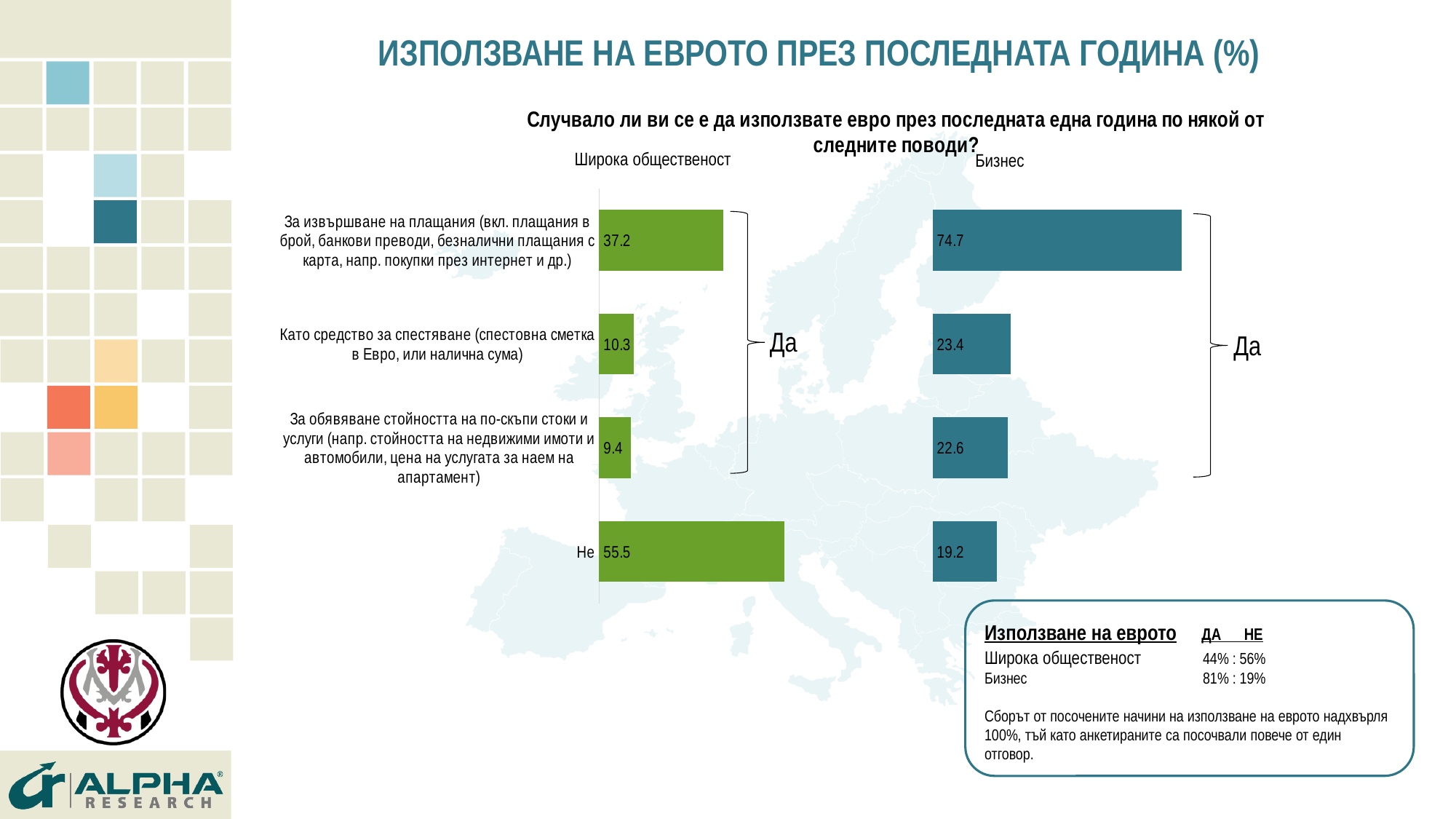
In the "Бизнес" chart, which category has the highest value? За извършване на плащания In the "Широка общественост" chart, which category has the lowest value? За обявяване стойността на по-скъпи стоки и услуги In the "Широка общественост" chart, what is the value for "Като средство за спестяване"? 10.3 In the "Бизнес" chart, what is the value for "Не"? 19.2 In the "Широка общественост" chart, what is the value for "Не"? 55.5 In the "Бизнес" chart, what is the value for "За извършване на плащания"? 74.7 What type of chart is used for the "Бизнес" data? Bar chart Which is larger: the value for "За извършване на плащания" in the "Широка общественост" chart or in the "Бизнес" chart? Бизнес What colour are the bars in the "Широка общественост" chart? Green How many categories are shown in the "Широка общественост" chart? 4 In the "Широка общественост" chart, what is the difference between the values for "Не" and "За извършване на плащания"? 18.3 In the "Бизнес" chart, what is the difference between the values for "Като средство за спестяване" and "За обявяване стойността на по-скъпи стоки и услуги"? 0.8